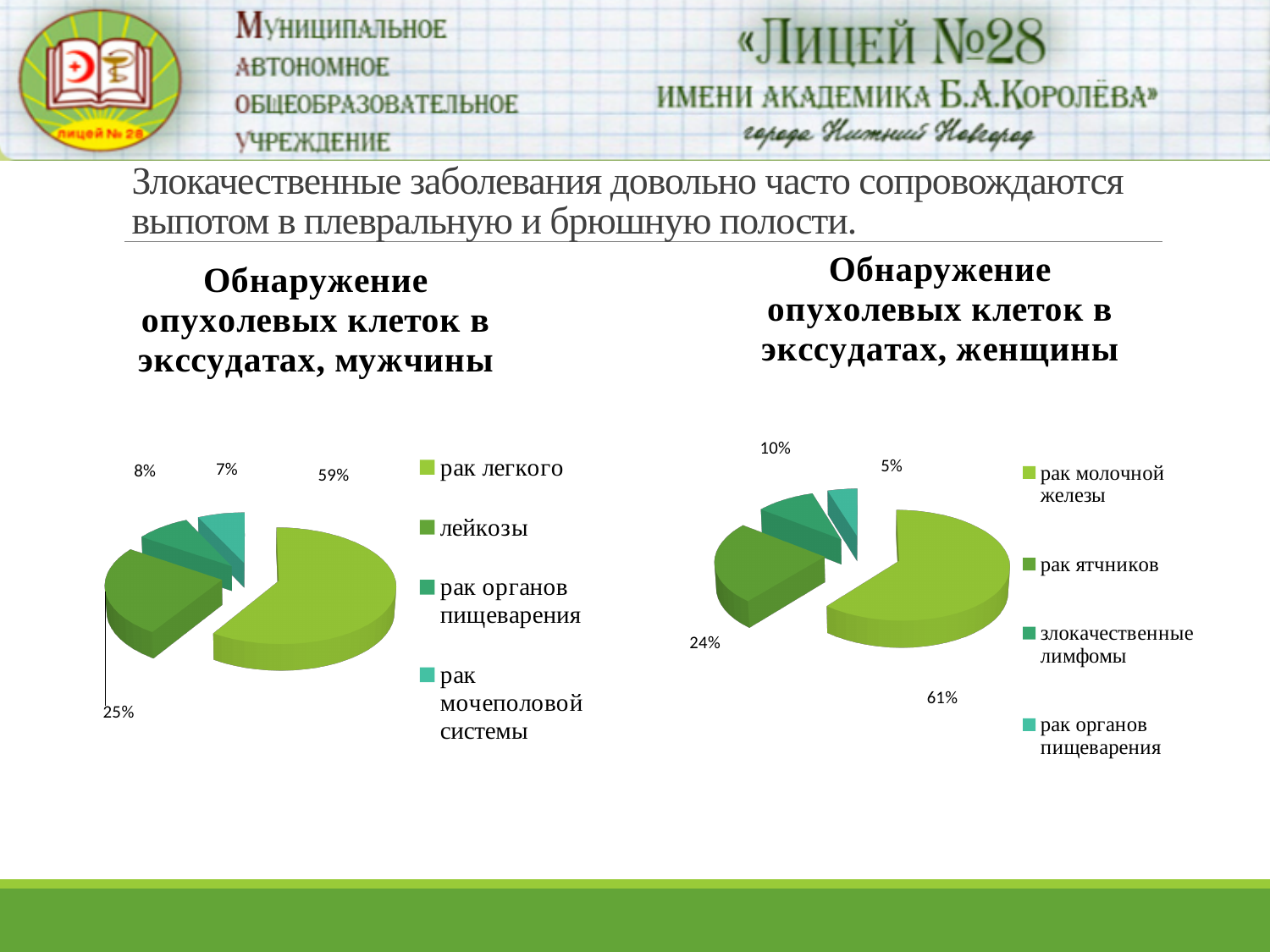
In the chart 'Обнаружение опухолевых клеток в экссудатах, мужчины', what is the difference between the shares for рак легкого and лейкозы? 34% In the chart 'Обнаружение опухолевых клеток в экссудатах, женщины', which is larger: the share for рак ятчников or the share for злокачественные лимфомы? рак ятчников In the chart 'Обнаружение опухолевых клеток в экссудатах, женщины', what share is labelled for злокачественные лимфомы? 10% In the chart 'Обнаружение опухолевых клеток в экссудатах, мужчины', how many categories does the legend list? 4 In the chart 'Обнаружение опухолевых клеток в экссудатах, женщины', what is the difference between the shares for рак ятчников and рак органов пищеварения? 19% In the chart 'Обнаружение опухолевых клеток в экссудатах, мужчины', which category has the smallest share? рак мочеполовой системы In the chart 'Обнаружение опухолевых клеток в экссудатах, женщины', what share is labelled for рак молочной железы? 61% In the chart 'Обнаружение опухолевых клеток в экссудатах, мужчины', what share is labelled for лейкозы? 25% In the chart 'Обнаружение опухолевых клеток в экссудатах, женщины', which category has the largest share? рак молочной железы How many pie charts are shown on the slide? 2 What type of chart is used for 'Обнаружение опухолевых клеток в экссудатах, женщины'? Pie chart In the chart 'Обнаружение опухолевых клеток в экссудатах, мужчины', what share is labelled for рак легкого? 59%